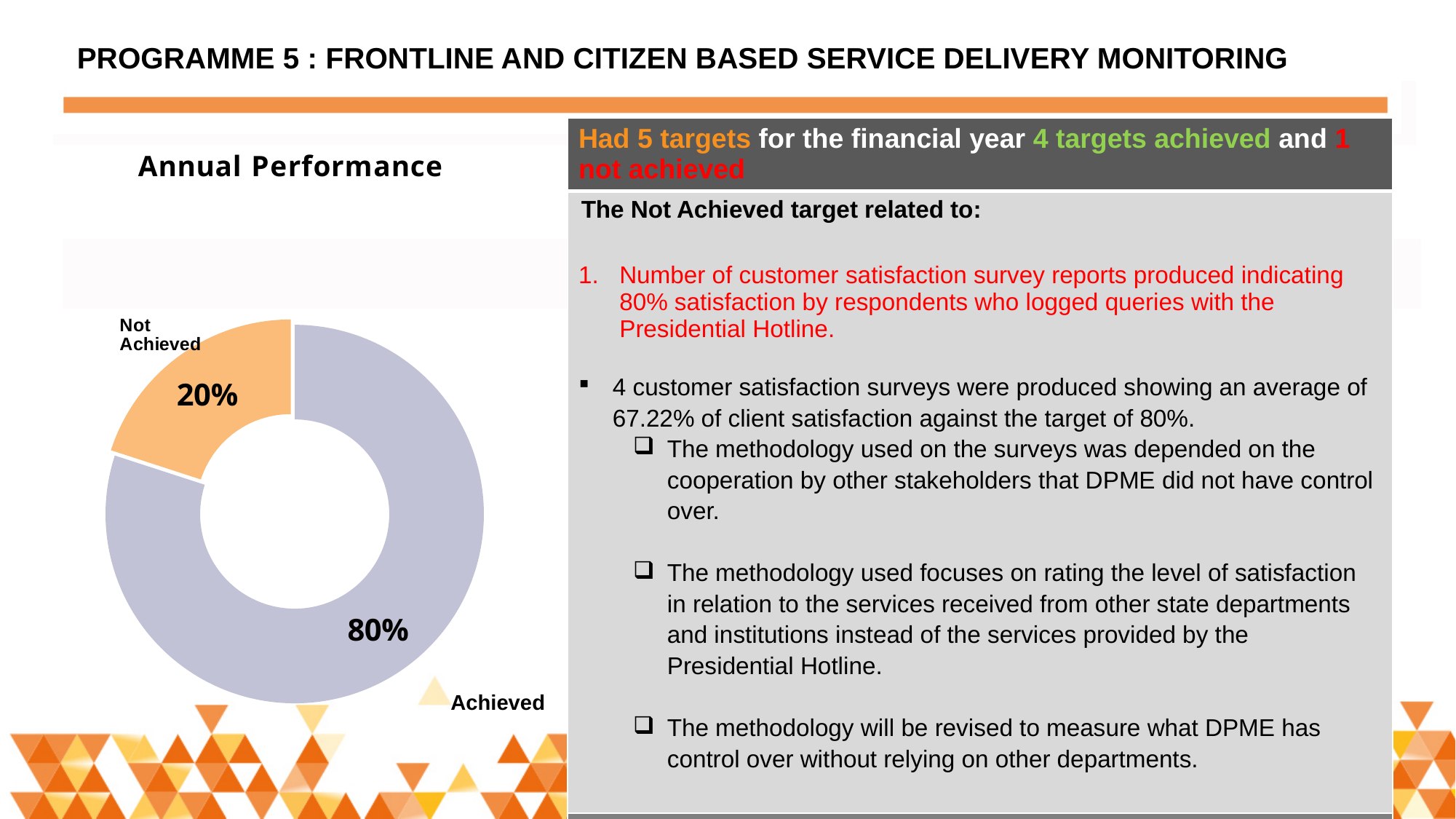
What kind of chart is shown under the heading Annual Performance? Doughnut chart How many categories are shown in the Annual Performance chart? 2 Is the Achieved share larger or smaller than the Not Achieved share in the Annual Performance chart? Larger Do the two shares in the Annual Performance chart add up to 100%? Yes What is the title of the chart on the left of the slide? Annual Performance What is the difference in percentage points between the Achieved and Not Achieved shares in the Annual Performance chart? 60 Which category has the smallest share in the Annual Performance chart? Not Achieved What percentage of targets is shown as Not Achieved in the Annual Performance chart? 20% Which category has the largest share in the Annual Performance chart? Achieved What percentage of targets is shown as Achieved in the Annual Performance chart? 80% What colour is the Not Achieved segment in the Annual Performance chart? Orange